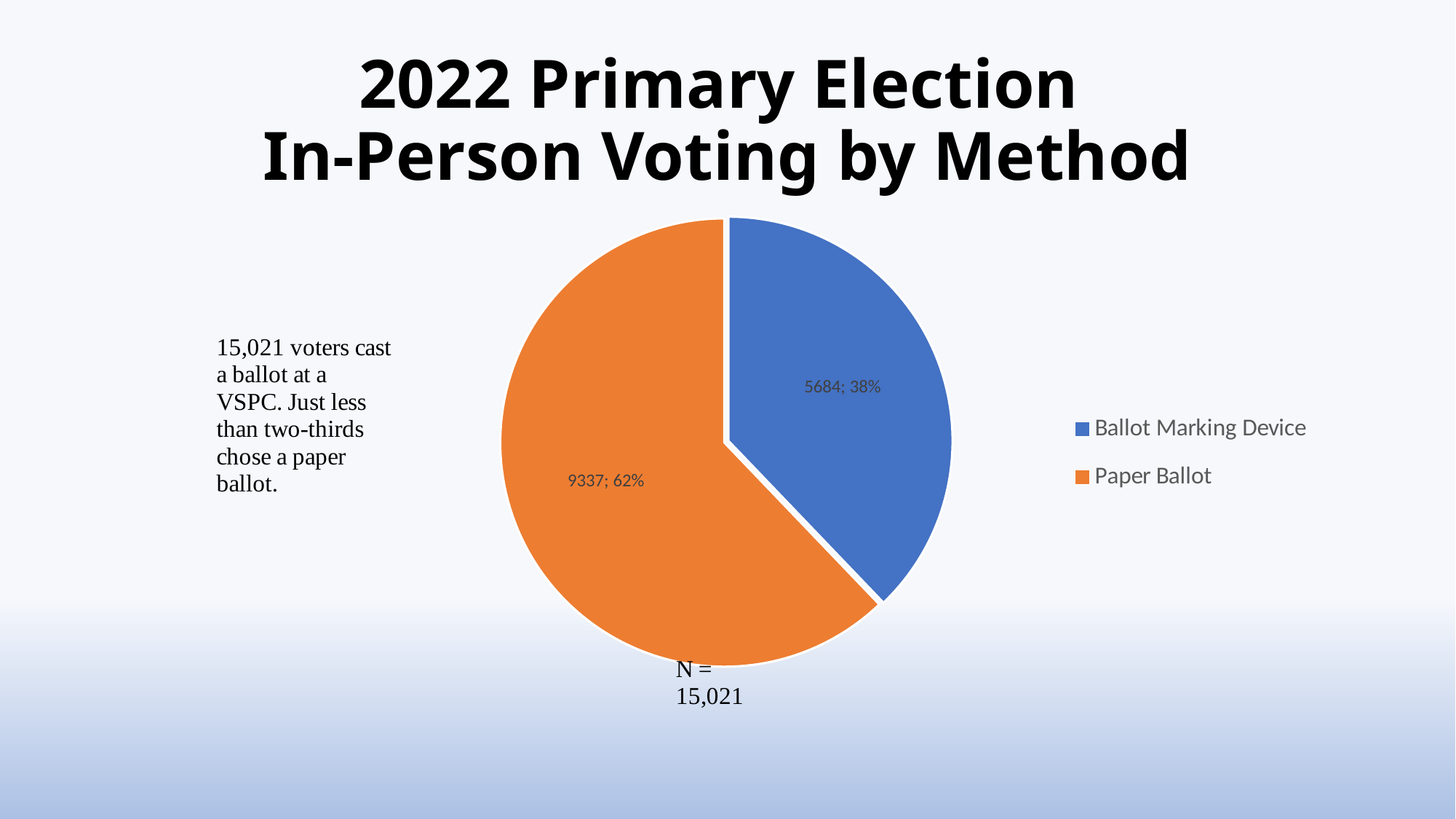
Which voting method has the largest slice? Paper Ballot Which is larger, the Paper Ballot count or the Ballot Marking Device count? Paper Ballot What type of chart is shown on the slide? pie chart What colour is the Paper Ballot slice? orange How many slices does the pie chart have? 2 Which voting method has the smallest slice? Ballot Marking Device How many entries does the legend list? 2 How many voters used a Ballot Marking Device? 5684 What share of the pie does Paper Ballot represent? 62% What is the difference in voters between Paper Ballot and Ballot Marking Device? 3653 How many voters chose a Paper Ballot? 9337 What share of the pie does Ballot Marking Device represent? 38%